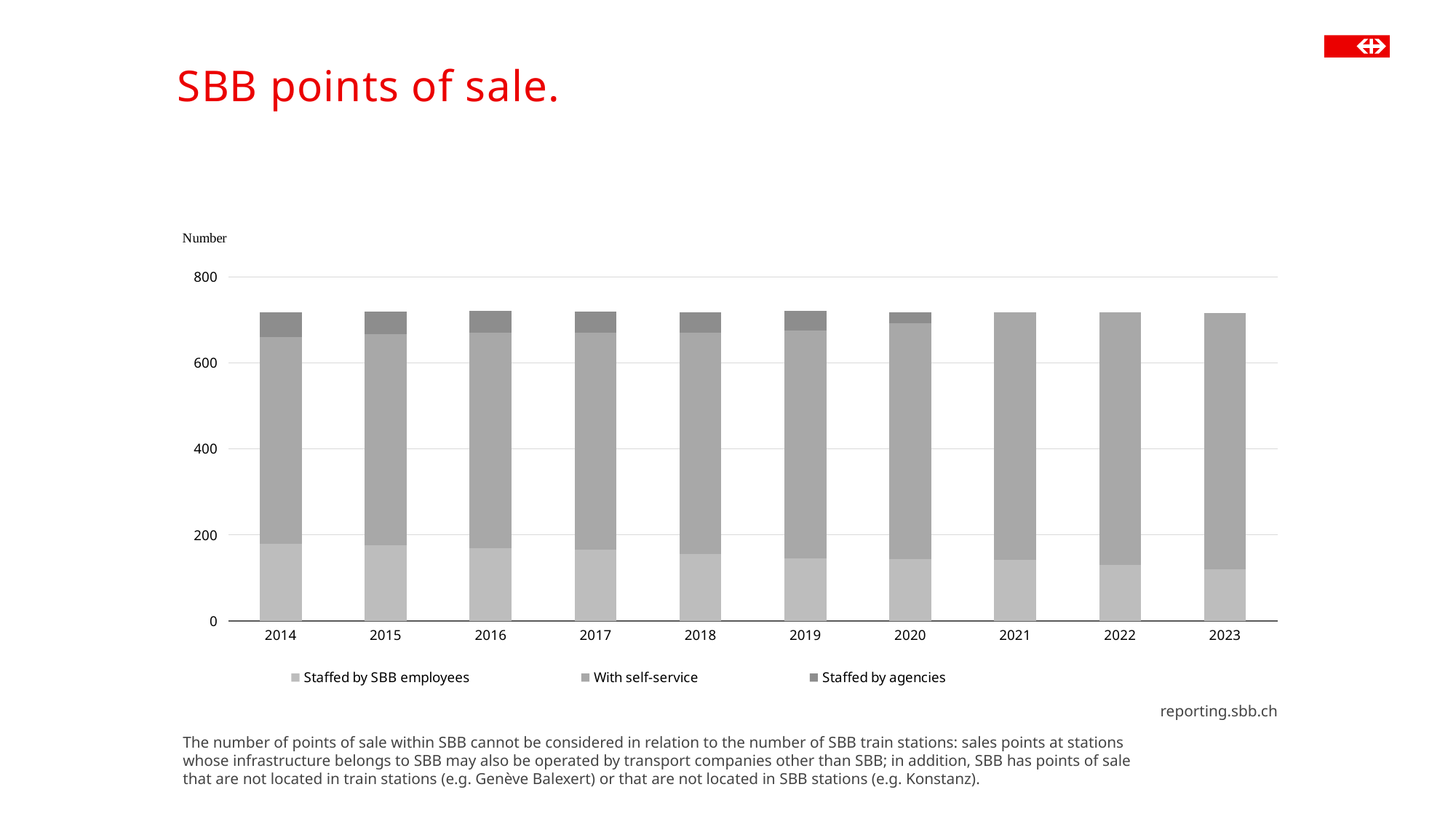
Is the value for 'Staffed by SBB employees' in 2014 greater or less than 200? less What kind of chart is shown on the slide? stacked bar chart Is the value for 'Staffed by SBB employees' in 2023 greater or less than 200? less What label is shown on the vertical axis of the chart? Number Which year has the larger 'Staffed by SBB employees' value, 2014 or 2023? 2014 Is the total number of points of sale in 2014 greater or less than 600? greater How many series does the legend list? 3 How many years are shown on the x axis of the chart? 10 Does the 'Staffed by SBB employees' series rise or fall from 2014 to 2023? fall What is the title of the slide? SBB points of sale.